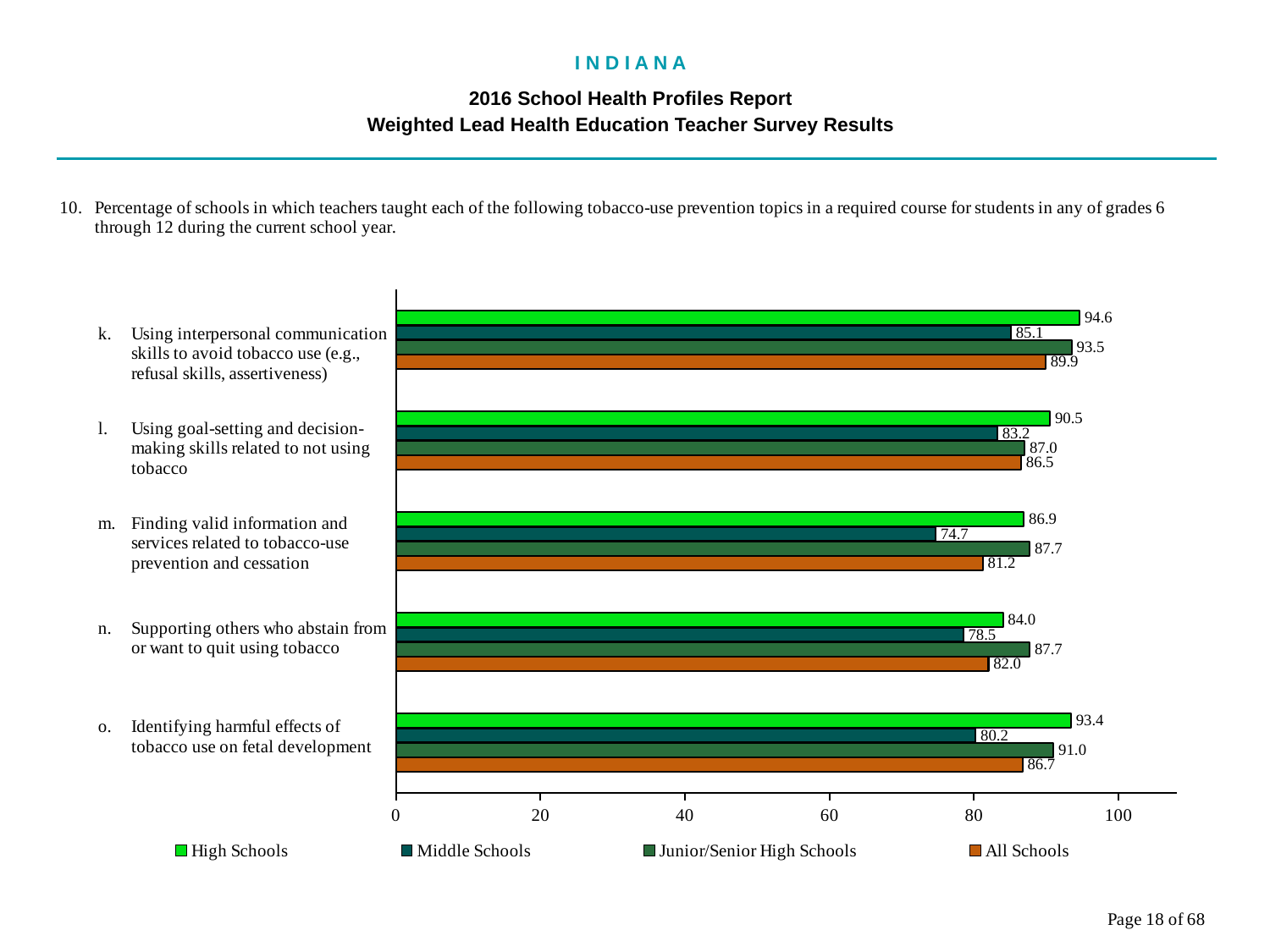
What is the Middle Schools value for topic m, finding valid information and services related to tobacco-use prevention and cessation? 74.7 How many series does the legend list? 4 For topic l, using goal-setting and decision-making skills, which is larger: the High Schools value or the Junior/Senior High Schools value? High Schools What is the High Schools value for topic k, using interpersonal communication skills to avoid tobacco use? 94.6 How many tobacco-use prevention topics are shown in the chart? 5 Which topic has the highest All Schools value? k. Using interpersonal communication skills to avoid tobacco use What is the All Schools value for topic o, identifying harmful effects of tobacco use on fetal development? 86.7 What is the difference between the High Schools and Middle Schools values for topic o, identifying harmful effects of tobacco use on fetal development? 13.2 Which topic has the lowest Middle Schools value? m. Finding valid information and services related to tobacco-use prevention and cessation Is the Middle Schools value for topic n, supporting others who abstain from or want to quit using tobacco, greater or less than 80? less What is the Junior/Senior High Schools value for topic n, supporting others who abstain from or want to quit using tobacco? 87.7 What kind of chart is shown on the slide? Bar chart